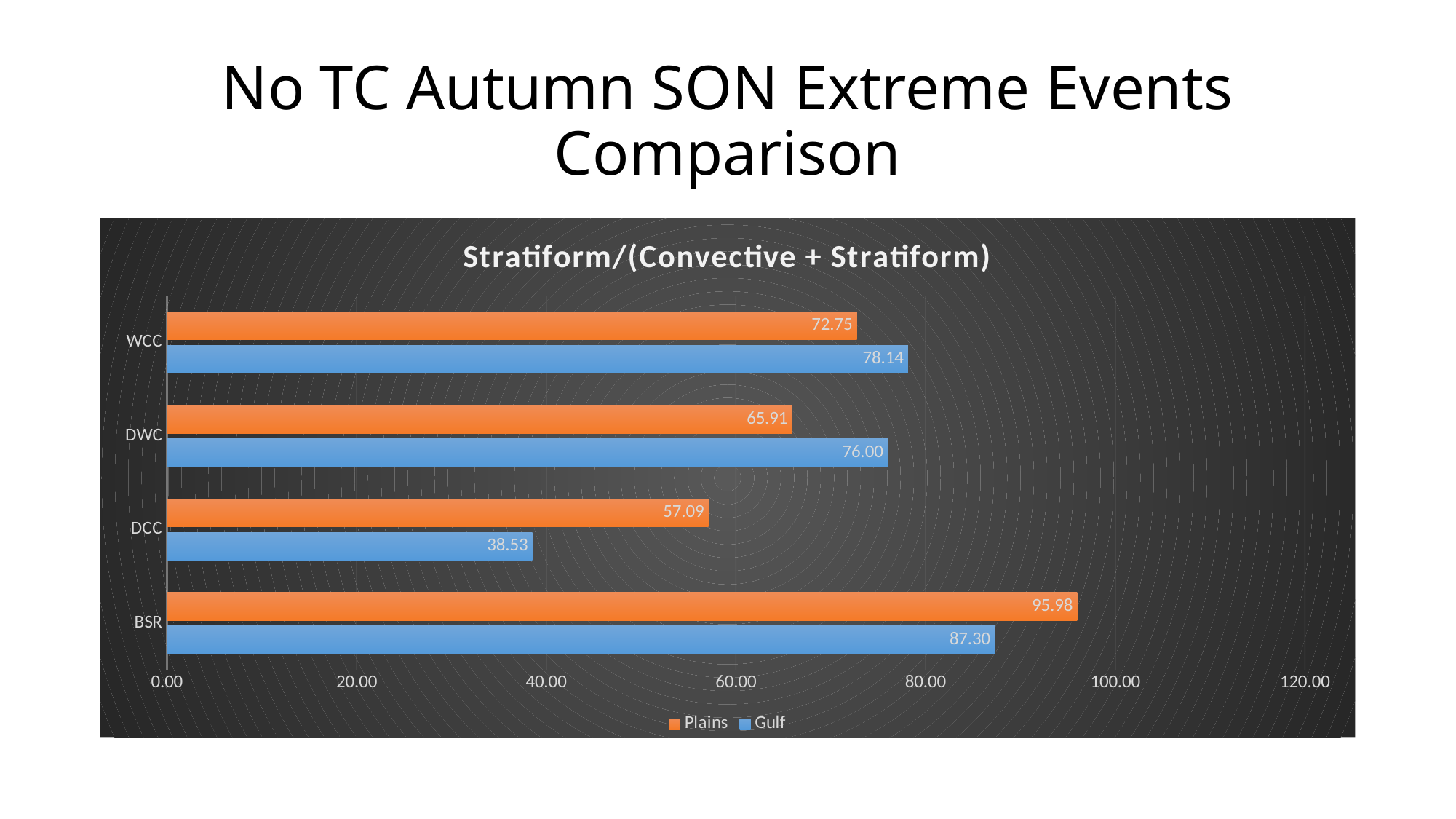
What is the Gulf value for DCC? 38.53 How many series does the legend list? 2 For WCC, which is larger, the Plains value or the Gulf value? Gulf What is the Plains value for WCC? 72.75 For DCC, which is larger, the Plains value or the Gulf value? Plains What is the difference between the Plains and Gulf values for BSR? 8.68 How many categories are shown on the chart? 4 Which category has the highest Plains value? BSR Which category has the lowest Gulf value? DCC What kind of chart is shown on the slide? Bar chart What is the title of the chart? Stratiform/(Convective + Stratiform) What is the Gulf value for DWC? 76.00